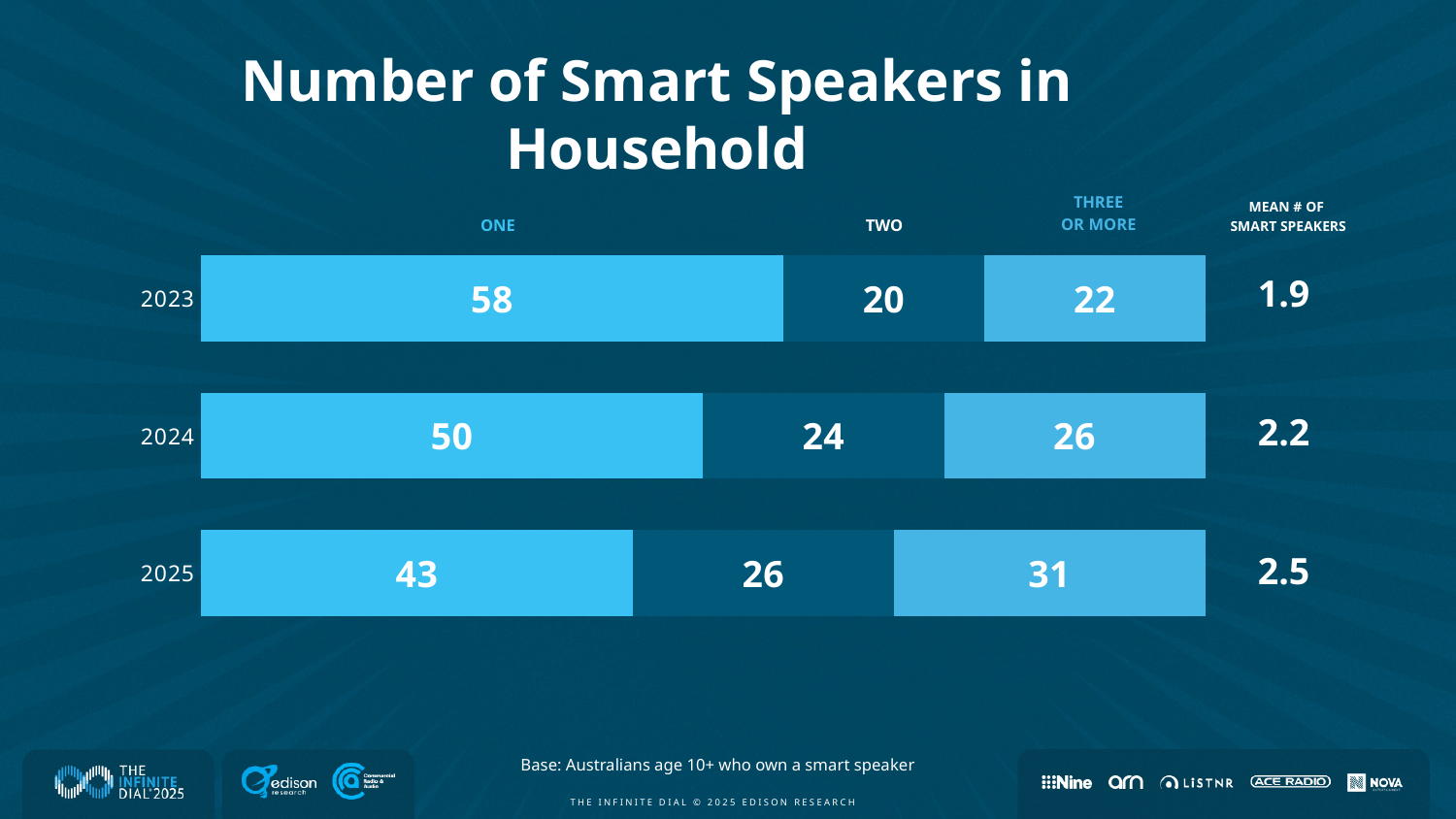
What is the value for "One" smart speaker in 2023? 58 What kind of chart is this? Stacked bar chart How many years are shown in the chart? 3 Which year has the lowest value for "Two" smart speakers? 2023 What is the mean number of smart speakers shown for 2024? 2.2 What is the difference between the "One" values for 2023 and 2025? 15 How many segments (categories) make up each bar? 3 Does the "One" smart speaker value rise or fall from 2023 to 2025? Fall Which year has the highest value for "One" smart speaker? 2023 Which is larger: the "Three or more" value in 2024 or the "Two" value in 2024? Three or more (26) What is the value for "Three or more" smart speakers in 2025? 31 What is the total of the three segments for the 2025 bar? 100